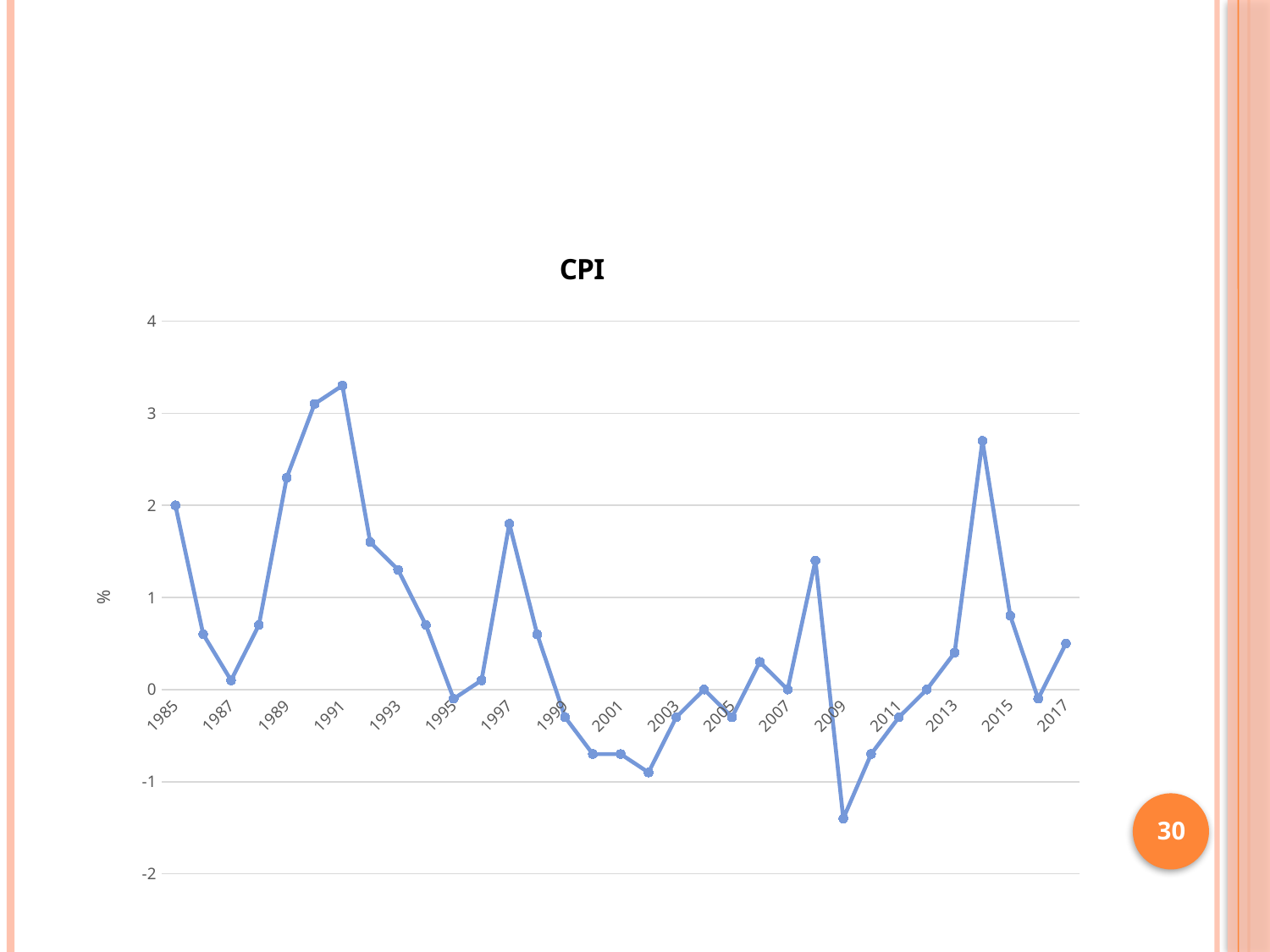
Is the CPI value for 1991 greater or less than 2? greater What is the title of the chart? CPI What is the label on the vertical axis of the chart? % Which labeled year has the lowest CPI value? 2009 Which year has the larger CPI value, 1991 or 2015? 1991 What kind of chart is shown on the slide? line chart Does the CPI value rise or fall from 1985 to 1987? fall How many years are labeled on the x axis? 17 Is the CPI value for 2009 greater or less than -1? less Is the CPI value for 2013 greater or less than 1? less What is the CPI value for 2007? 0 What is the CPI value for 1985? 2